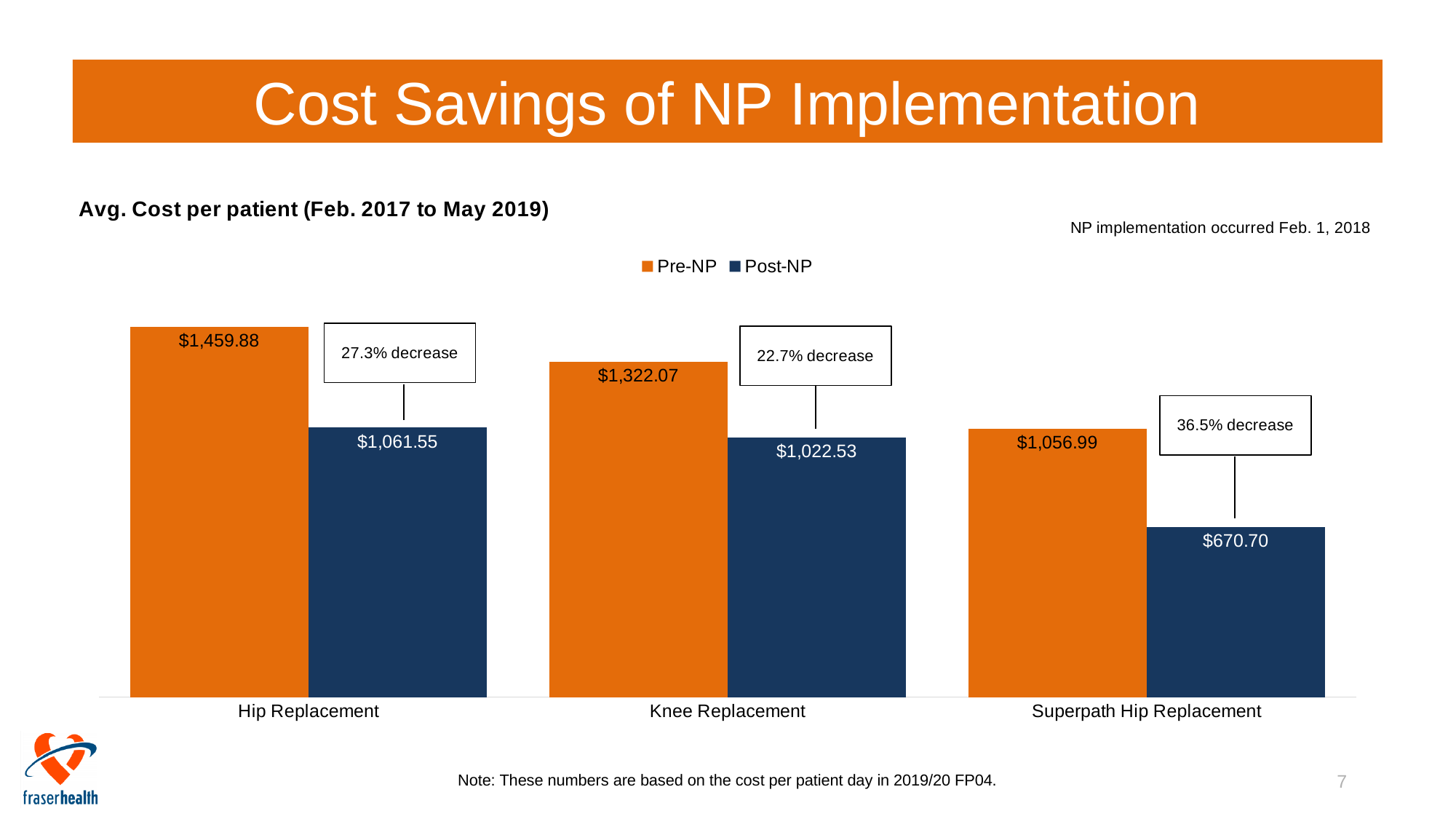
What is the difference between the Pre-NP and Post-NP cost for Hip Replacement? $398.33 What kind of chart is shown on the slide? Bar chart How many procedure categories are shown on the x axis? 3 Which procedure has the lowest Post-NP average cost per patient? Superpath Hip Replacement What percentage decrease is labelled for Knee Replacement? 22.7% decrease What is the difference between the Pre-NP and Post-NP cost for Superpath Hip Replacement? $386.29 What is the Post-NP average cost per patient for Knee Replacement? $1,022.53 What is the Post-NP average cost per patient for Superpath Hip Replacement? $670.70 Which is larger: the Post-NP cost for Hip Replacement or the Pre-NP cost for Superpath Hip Replacement? Post-NP cost for Hip Replacement What is the Pre-NP average cost per patient for Hip Replacement? $1,459.88 Which procedure has the highest Pre-NP average cost per patient? Hip Replacement How many series does the legend list? 2